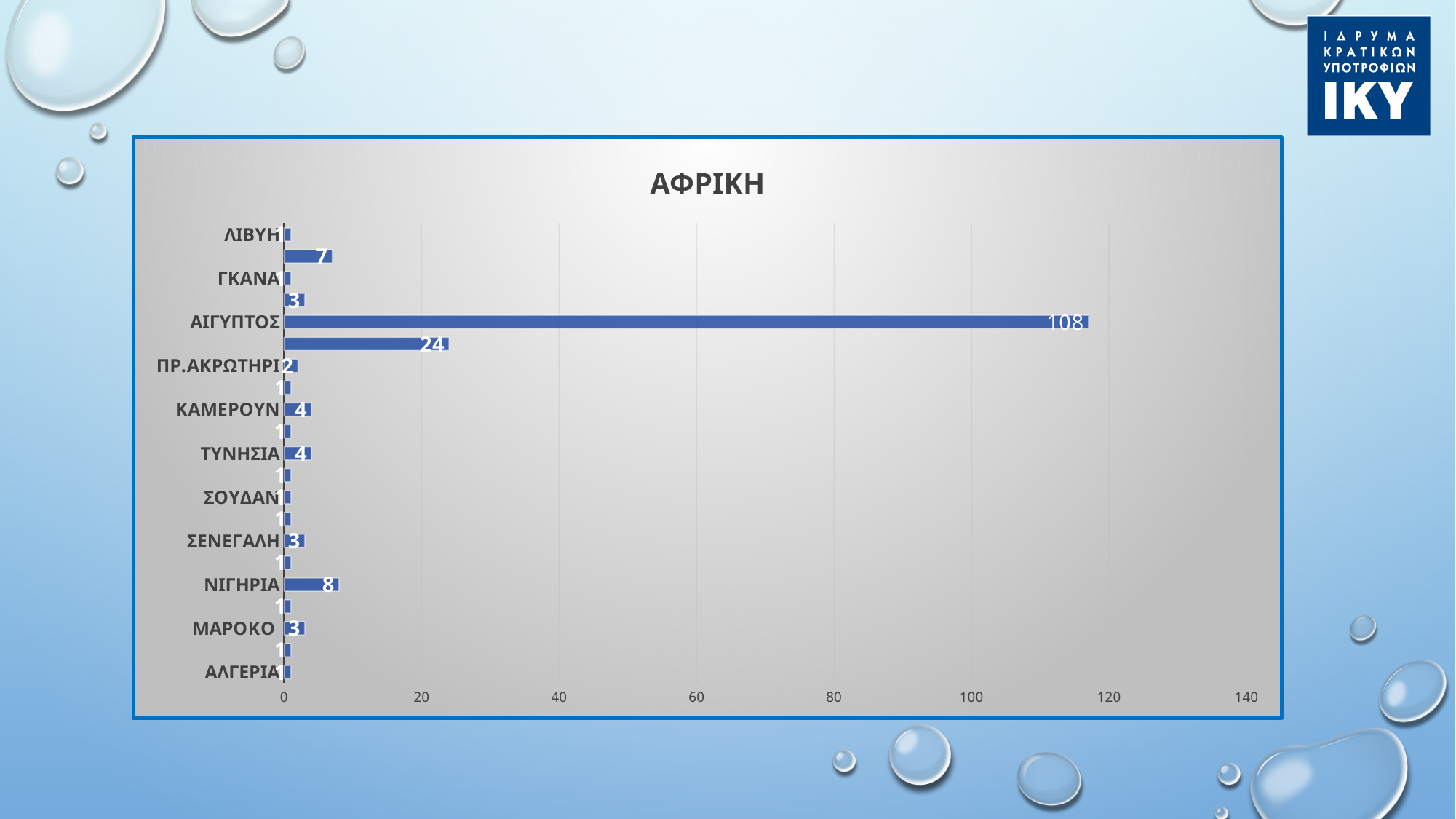
What is the value shown for ΚΑΜΕΡΟΥΝ? 4 What is the value shown for ΑΙΓΥΠΤΟΣ? 108 How many category labels are shown on the vertical axis of the chart? 11 What is the title of the chart? ΑΦΡΙΚΗ What is the difference between the values for ΑΙΓΥΠΤΟΣ and ΝΙΓΗΡΙΑ? 100 Which has the larger value, ΝΙΓΗΡΙΑ or ΜΑΡΟΚΟ? ΝΙΓΗΡΙΑ What kind of chart is shown on the slide? bar chart What is the value shown for ΝΙΓΗΡΙΑ? 8 What is the value shown for ΣΕΝΕΓΑΛΗ? 3 Which category has the highest value in the chart? ΑΙΓΥΠΤΟΣ Is the value for ΑΙΓΥΠΤΟΣ greater or less than 100? greater What is the value shown for ΠΡ.ΑΚΡΩΤΗΡΙ? 2